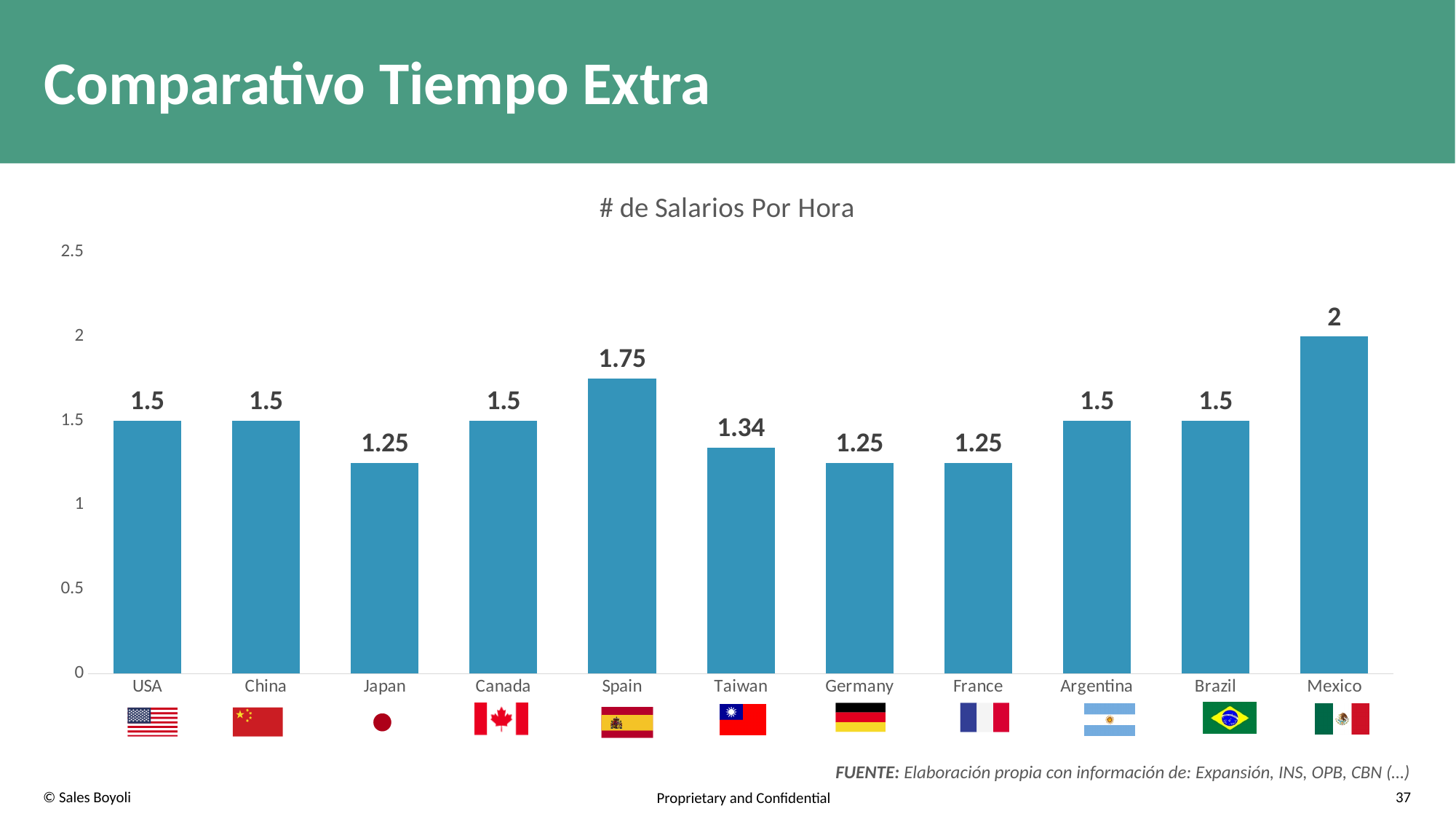
Is the value for Mexico greater or less than 1.5? greater How many countries are shown in the chart? 11 What is the title of the chart? # de Salarios Por Hora What is the value for Mexico? 2 Which is larger, the value for Taiwan or the value for France? Taiwan What is the difference between the values for Taiwan and Germany? 0.09 What is the value for Taiwan? 1.34 What is the value for Spain? 1.75 Which is larger, the value for Spain or the value for Canada? Spain What kind of chart is shown on the slide? Bar chart What is the difference between the values for Mexico and Spain? 0.25 Which country has the highest value? Mexico